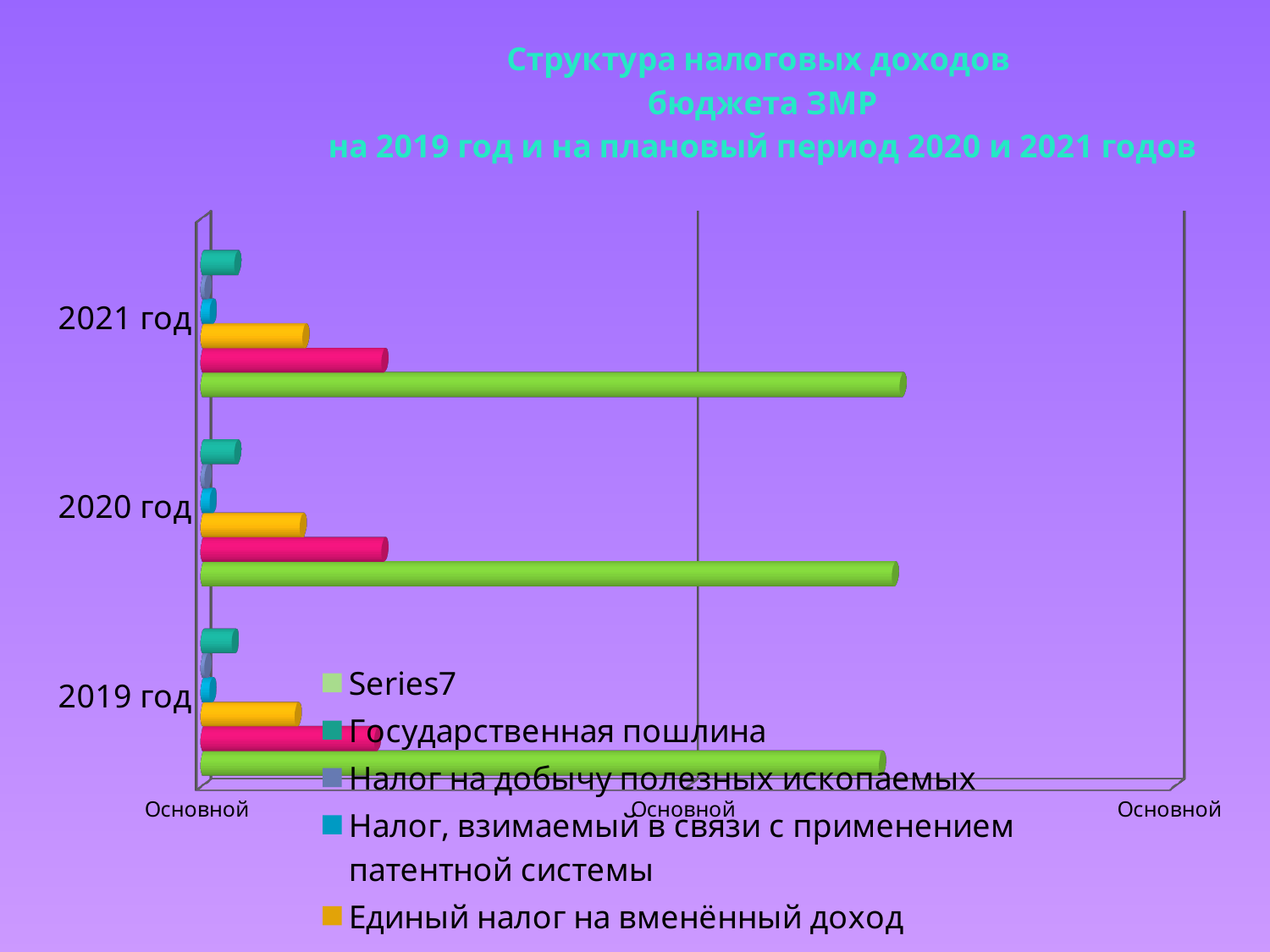
Which year categories are listed on the vertical axis of the chart? 2019 год, 2020 год, 2021 год What kind of chart is shown on the slide? Bar chart For 2019 год, which is larger: Государственная пошлина or Налог, взимаемый в связи с применением патентной системы? Государственная пошлина How many year categories are shown on the vertical axis of the chart? 3 How many series does the chart legend list? 5 For 2021 год, which is larger: Единый налог на вменённый доход or Государственная пошлина? Единый налог на вменённый доход Which legend series has the shortest bar for 2020 год? Налог на добычу полезных ископаемых What colour represents Единый налог на вменённый доход in the chart legend? Orange